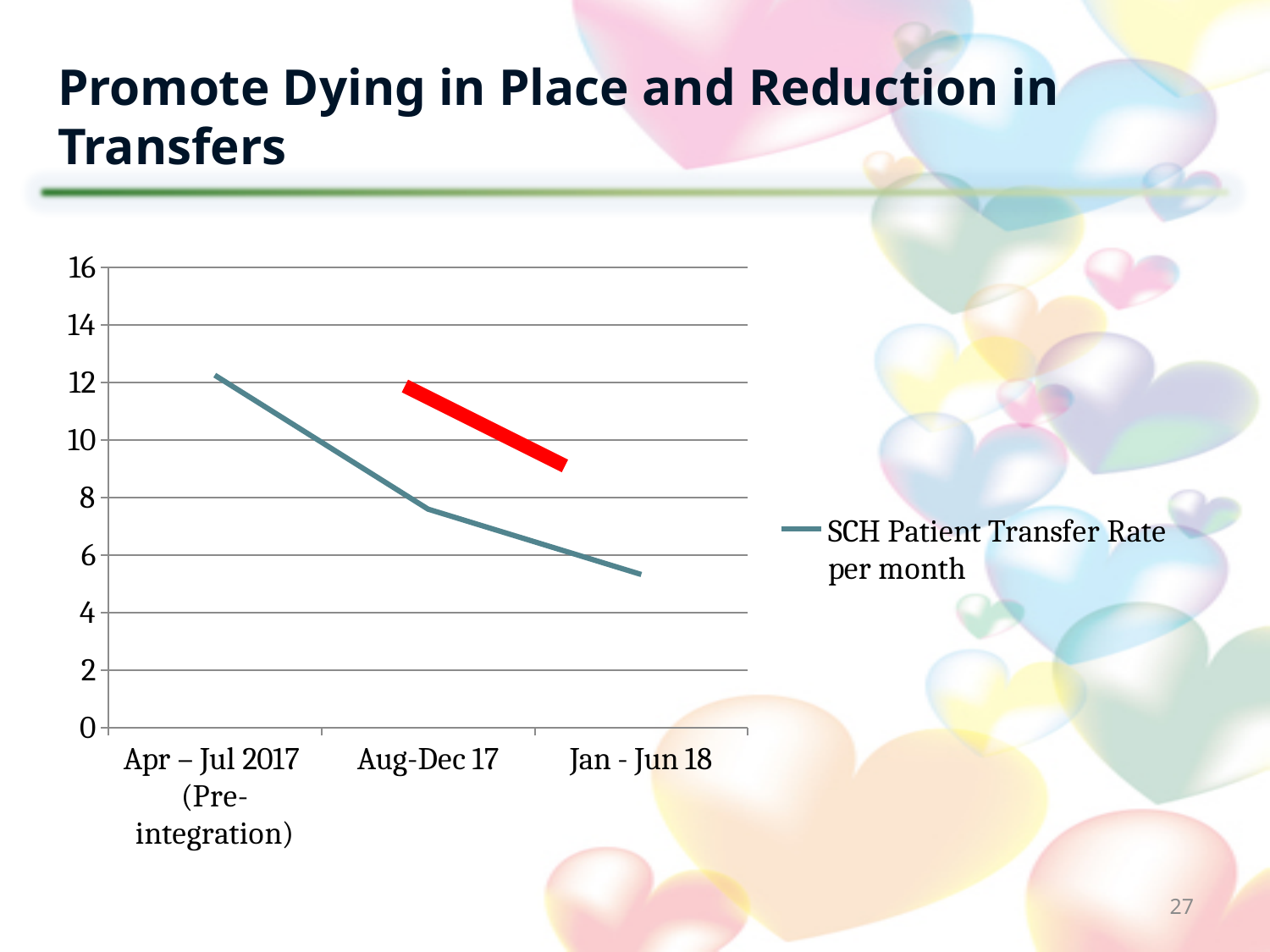
Is the SCH Patient Transfer Rate per month for Jan - Jun 18 greater or less than 6? less What kind of chart is shown on the slide? line chart Which period has the lowest SCH Patient Transfer Rate per month? Jan - Jun 18 Is the SCH Patient Transfer Rate per month for Apr – Jul 2017 (Pre-integration) greater or less than 10? greater How many series does the chart legend list? 1 What is the highest value shown on the chart's vertical axis? 16 How many periods are plotted along the x axis of the chart? 3 Which period has a higher SCH Patient Transfer Rate per month, Aug-Dec 17 or Jan - Jun 18? Aug-Dec 17 Which period has the highest SCH Patient Transfer Rate per month? Apr – Jul 2017 (Pre-integration) Is the SCH Patient Transfer Rate per month for Aug-Dec 17 greater or less than 10? less Do the values of the SCH Patient Transfer Rate per month rise or fall from Apr – Jul 2017 to Jan - Jun 18? fall What is the name of the series shown in the chart legend? SCH Patient Transfer Rate per month